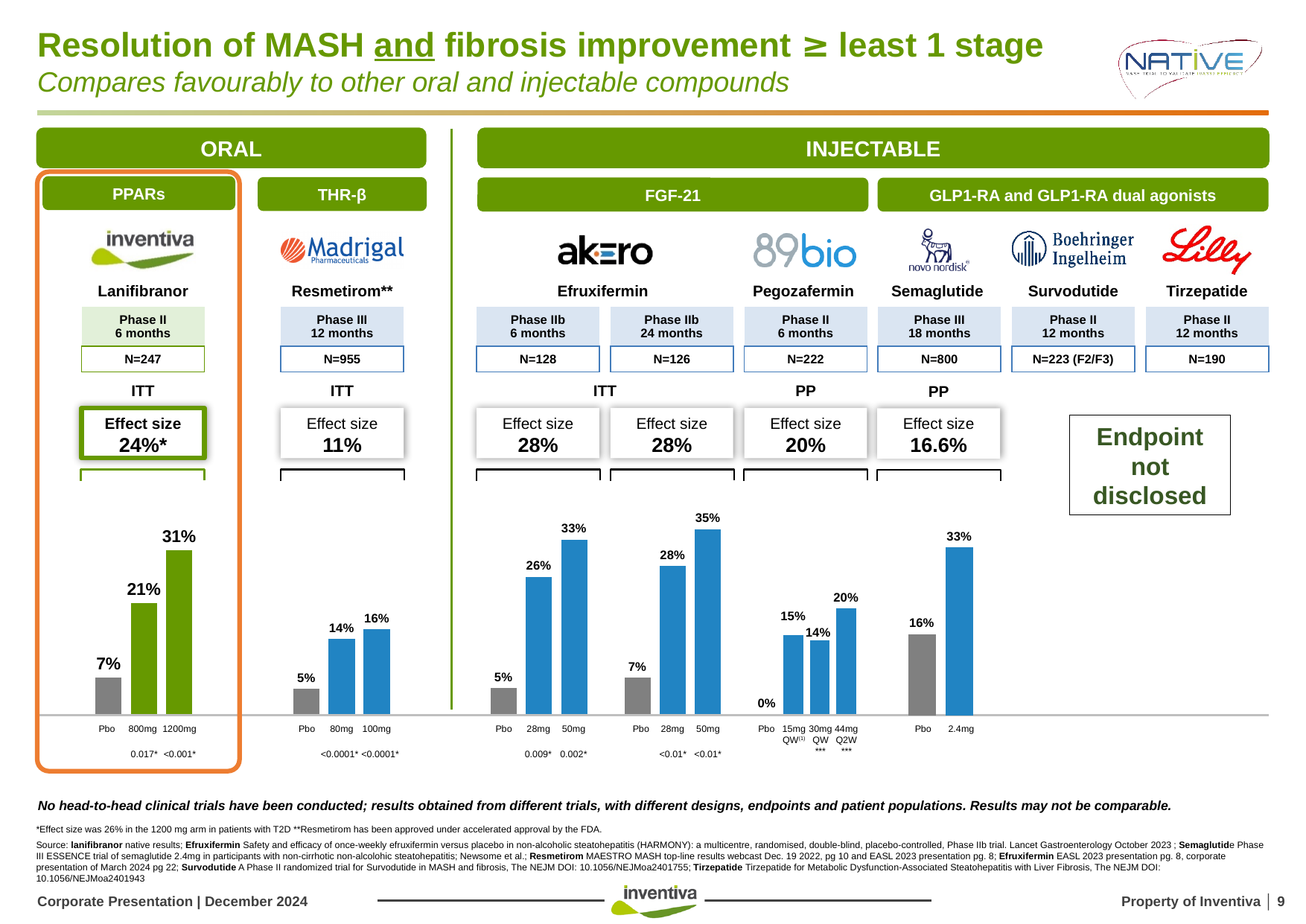
In the Lanifibranor chart, what is the difference between the 1200mg arm and placebo (Pbo)? 24% In the Pegozafermin chart, how many bars are plotted? 4 In the Semaglutide chart, what is the value for the 2.4mg arm? 33% What type of chart is used to show the Lanifibranor results? Bar chart In the Pegozafermin chart, which is larger: the 15mg QW arm or the 30mg QW arm? 15mg QW In the Lanifibranor chart, what is the value for the 1200mg arm? 31% In the Efruxifermin Phase IIb 24 months chart, what is the difference between the 50mg arm and placebo (Pbo)? 28% In the Lanifibranor chart, do the values rise or fall from Pbo to 1200mg? Rise In the Pegozafermin chart, which arm has the lowest value? Pbo In the Resmetirom chart, what is the value for the 80mg arm? 14% In the Efruxifermin Phase IIb 6 months chart, what is the value for the 50mg arm? 33% In the Resmetirom chart, which arm has the highest value? 100mg